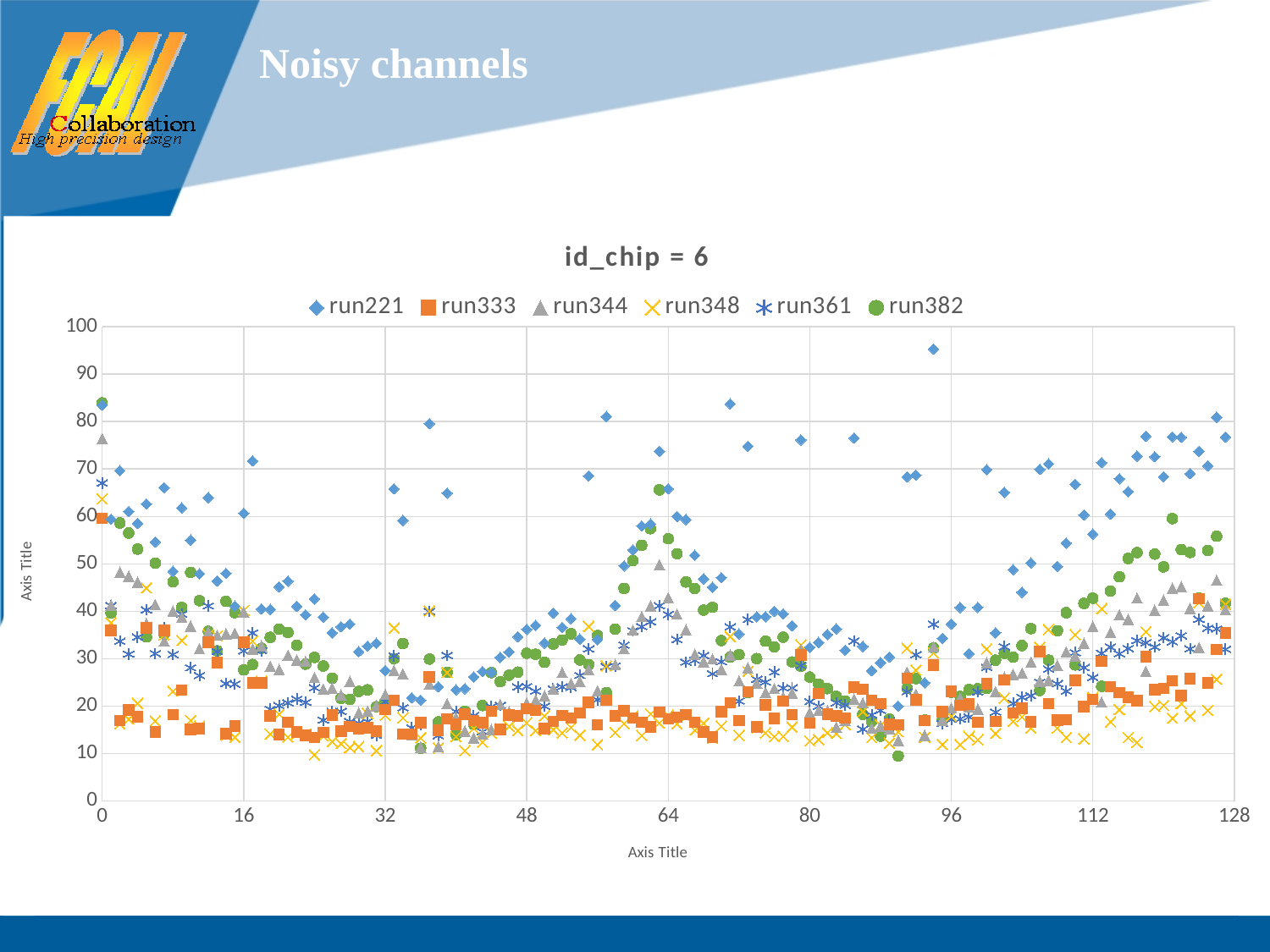
Is the value for run221 at x = 0 greater or less than 50? greater At x = 0, which series has the larger value, run382 or run333? run382 What kind of chart is shown on the slide? scatter chart How many series does the legend of the chart list? 6 How many tick labels are shown on the horizontal axis of the chart? 9 Which series contains the highest plotted point on the chart? run221 What is the highest value shown on the vertical axis of the chart? 100 Is the highest run382 point near x = 64 greater or less than 50? greater What is the title of the chart? id_chip = 6 Is the highest run221 point on the chart greater or less than 90? greater